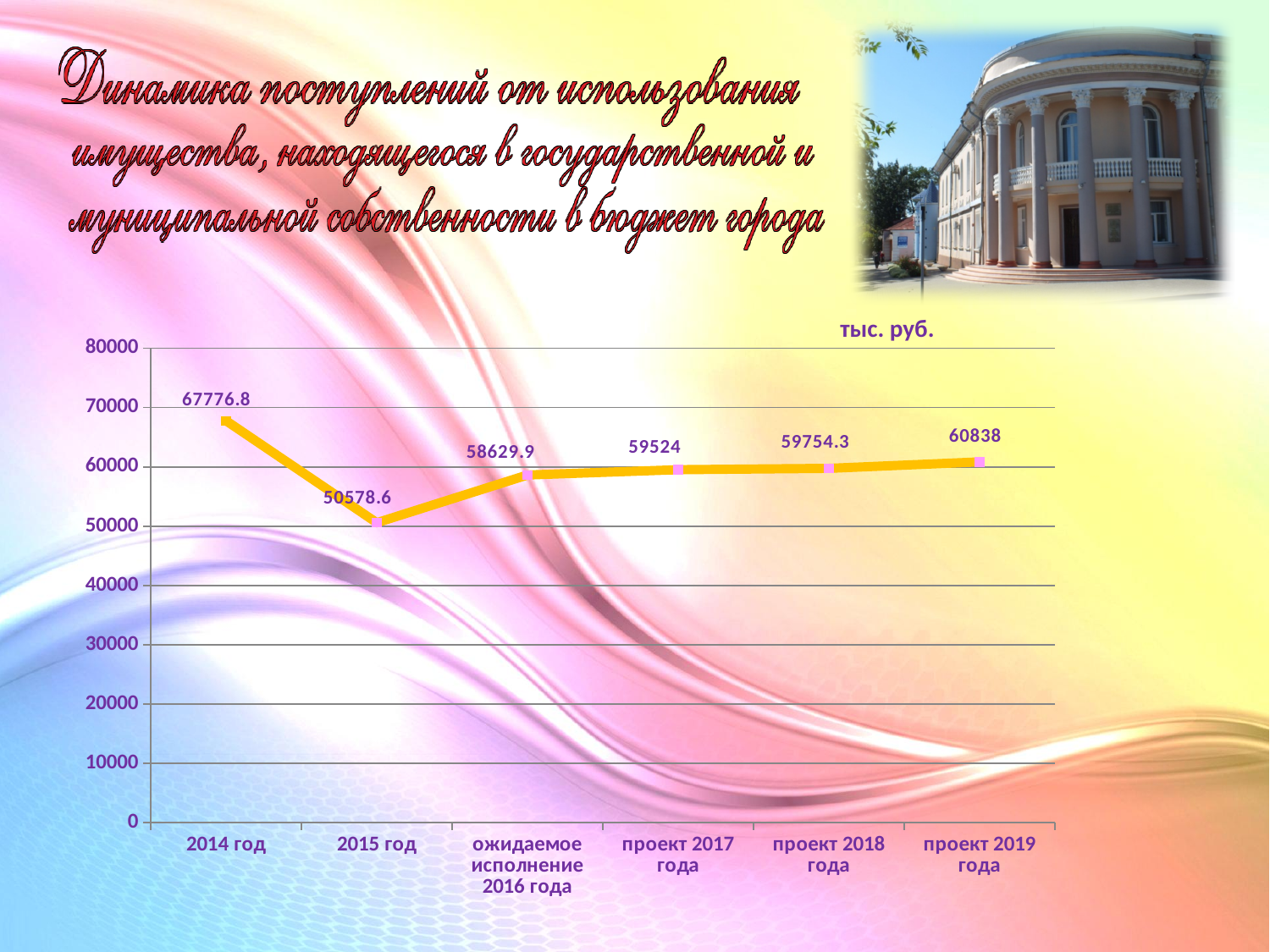
What is the value for проект 2019 года? 60838 What is the value for ожидаемое исполнение 2016 года? 58629.9 Which category has the lowest value? 2015 год Which is larger, the value for проект 2017 года or проект 2018 года? проект 2018 года What is the value for 2015 год? 50578.6 What is the value for 2014 год? 67776.8 What is the difference between the values for 2014 год and 2015 год? 17198.2 Do the values rise or fall from 2015 год to проект 2019 года? rise How many data points are plotted on the chart? 6 What type of chart is shown on the slide? line chart What unit is indicated above the chart? тыс. руб. Which category has the highest value? 2014 год